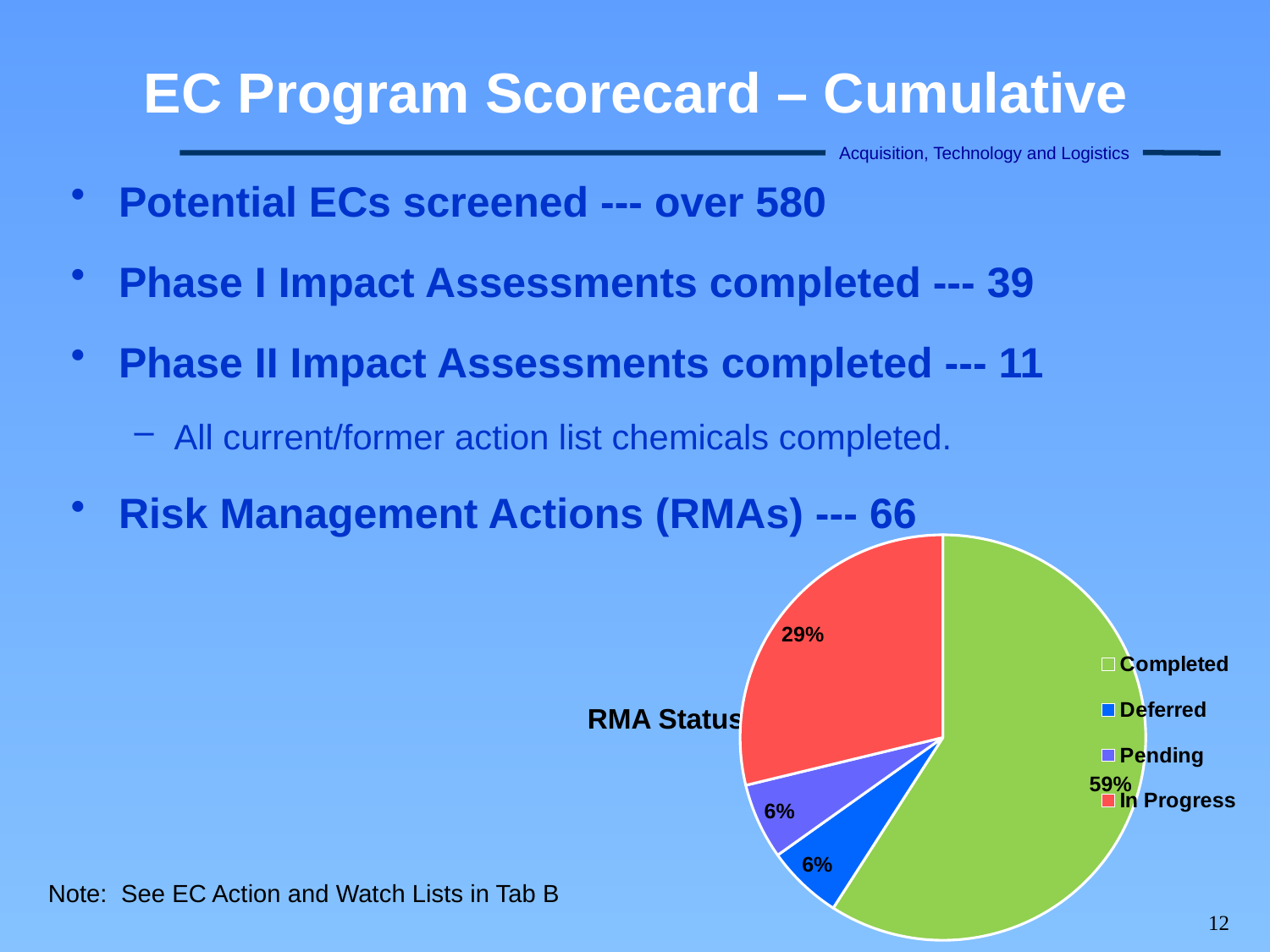
Which legend entry in the RMA Status chart is shown in red? In Progress Which is larger in the RMA Status chart, Completed or In Progress? Completed What share of the RMA Status pie is In Progress? 29% What percentage is shown for Pending in the RMA Status chart? 6% How many categories does the legend of the RMA Status chart list? 4 What kind of chart is shown on the slide? pie chart What share of the RMA Status pie is Completed? 59% What is the title of the chart? RMA Status What percentage is shown for Deferred in the RMA Status chart? 6% Which category has the largest slice in the RMA Status chart? Completed By how many percentage points does Completed exceed In Progress in the RMA Status chart? 30 How many slices does the RMA Status pie chart have? 4